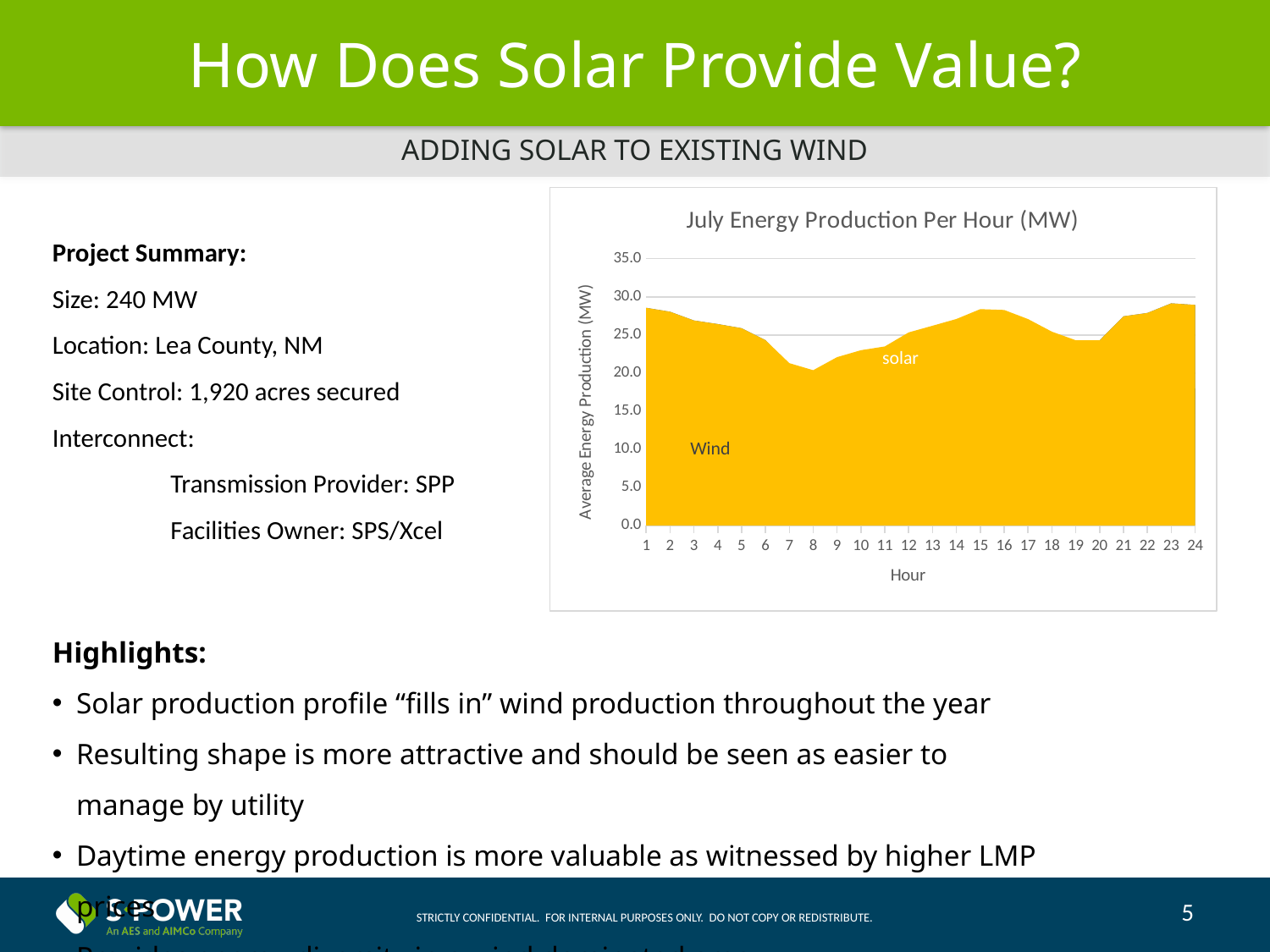
Which hour has the higher energy production, hour 15 or hour 19? Hour 15 Is the value for hour 8 greater or less than 25.0? less At which hour is the energy production lowest? 8 Is the value for hour 15 greater or less than 25.0? greater Is the value for hour 1 greater or less than 25.0? greater Which hour has the higher energy production, hour 1 or hour 8? Hour 1 What is the label of the vertical axis of the chart? Average Energy Production (MW) What kind of chart is shown on the slide? Area chart How many hours are plotted along the x axis of the chart? 24 Do the values rise or fall from hour 1 to hour 8? Fall What is the title of the chart? July Energy Production Per Hour (MW)